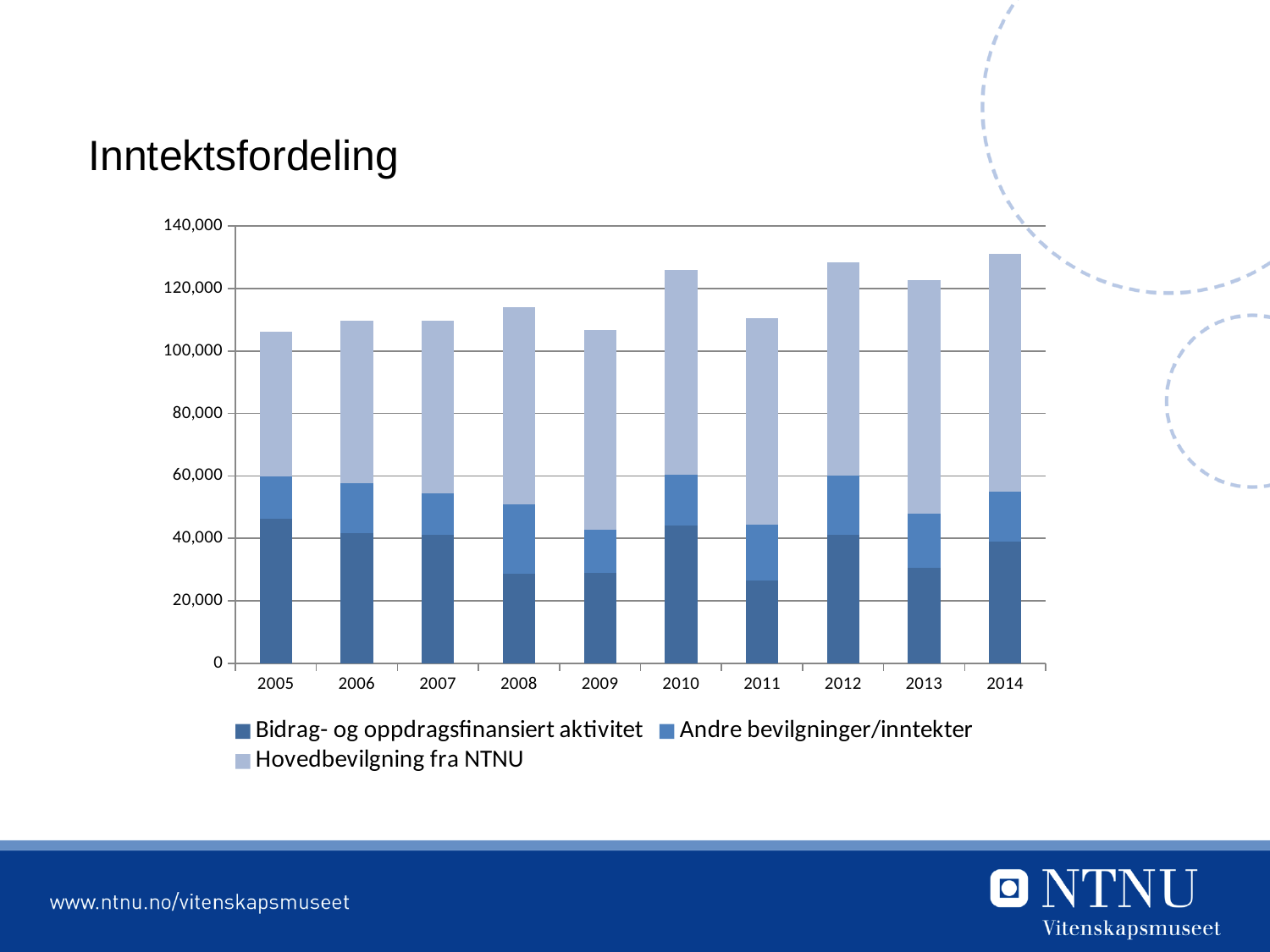
What is the title of the slide containing the chart? Inntektsfordeling Which year has the highest total stacked bar? 2014 How many series does the legend of the chart list? 3 Is the total stacked bar for 2005 greater or less than 120,000? less Which year has the larger value for Bidrag- og oppdragsfinansiert aktivitet, 2005 or 2009? 2005 What kind of chart is shown on the slide? Stacked bar chart Which series is shown in the lightest colour at the top of each stacked bar? Hovedbevilgning fra NTNU How many years are shown on the x axis of the chart? 10 Which year has the larger total stacked bar, 2011 or 2012? 2012 Is the value for Bidrag- og oppdragsfinansiert aktivitet in 2011 greater or less than 40,000? less Is the total stacked bar for 2014 greater or less than 120,000? greater